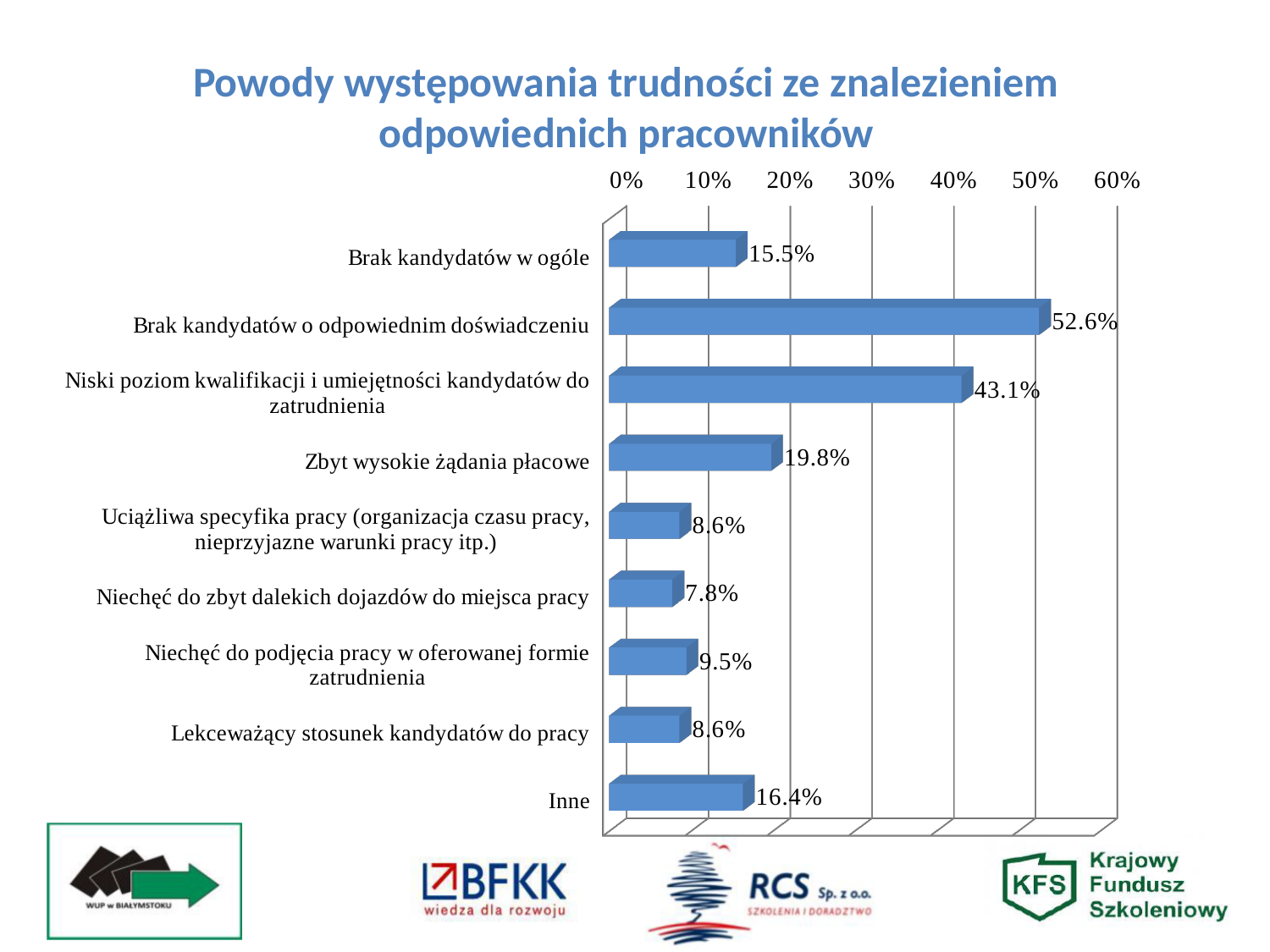
How many categories are shown in the chart? 9 What is the value for "Niechęć do zbyt dalekich dojazdów do miejsca pracy"? 7.8% Which category has the highest value? Brak kandydatów o odpowiednim doświadczeniu What kind of chart is shown on the slide? bar chart What is the difference between the values for "Brak kandydatów o odpowiednim doświadczeniu" and "Niski poziom kwalifikacji i umiejętności kandydatów do zatrudnienia"? 9.5% Which category has the lowest value? Niechęć do zbyt dalekich dojazdów do miejsca pracy What is the value for "Brak kandydatów o odpowiednim doświadczeniu"? 52.6% What is the value for "Zbyt wysokie żądania płacowe"? 19.8% Is the value for "Niski poziom kwalifikacji i umiejętności kandydatów do zatrudnienia" greater or less than 40%? greater Which is larger, the value for "Brak kandydatów w ogóle" or the value for "Inne"? Inne What is the title of the chart? Powody występowania trudności ze znalezieniem odpowiednich pracowników What is the value for "Inne"? 16.4%